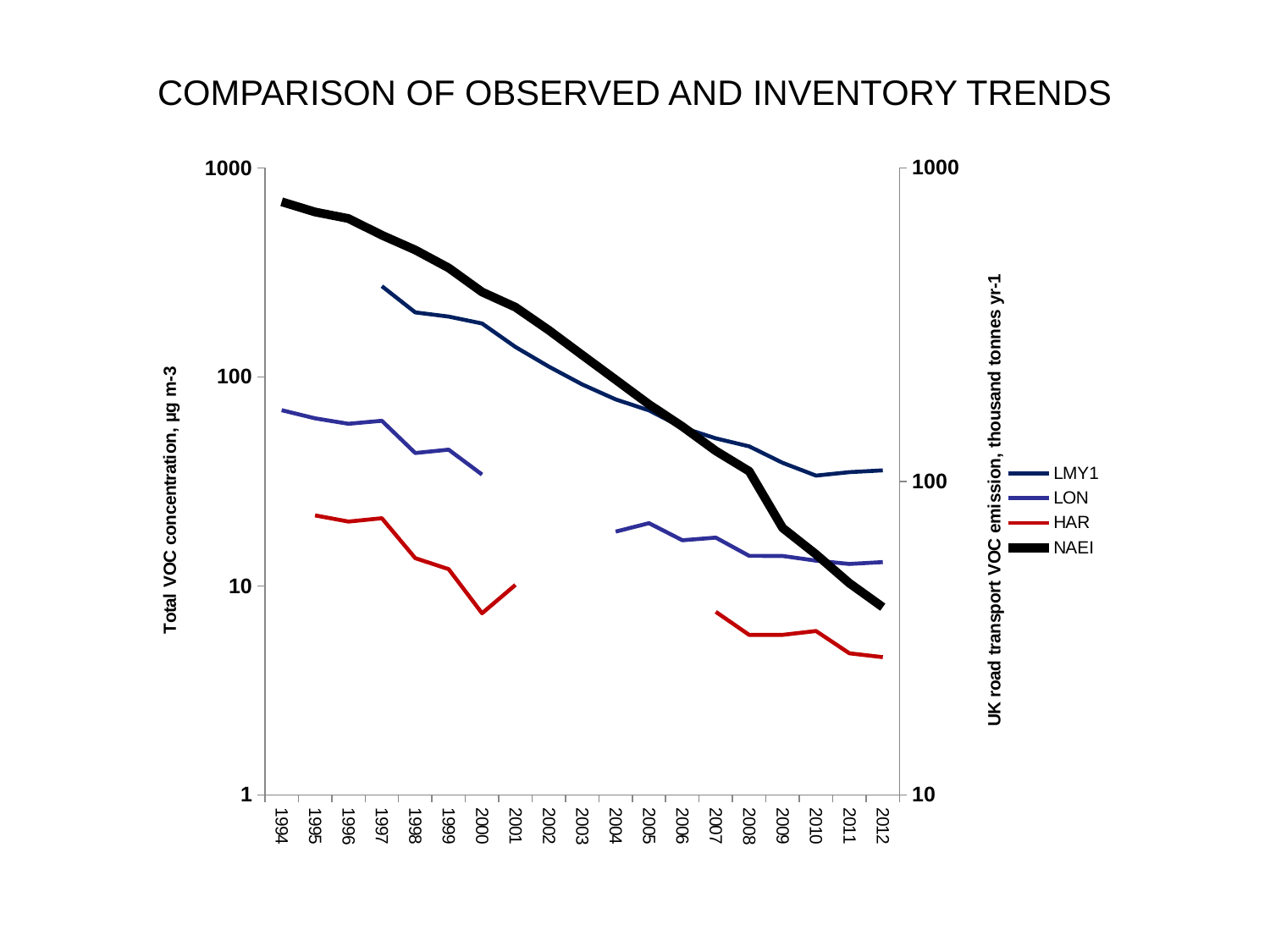
How many series does the legend list? 4 Is the value for NAEI in 2012 greater or less than 100 on the right axis? less Is the value for LON in 1994 greater or less than 100 on the left axis? less How many years are labelled on the x axis? 19 In 2005, which series has the higher value, LMY1 or LON? LMY1 Does the LMY1 series rise or fall from 1997 to 2010? fall What is the title of the chart? COMPARISON OF OBSERVED AND INVENTORY TRENDS Is the value for HAR in 2012 greater or less than 10 on the left axis? less In 2000, which series has the higher value, HAR or LON? LON What kind of chart is shown on the slide? line chart Does the NAEI series rise or fall from 1994 to 2012? fall